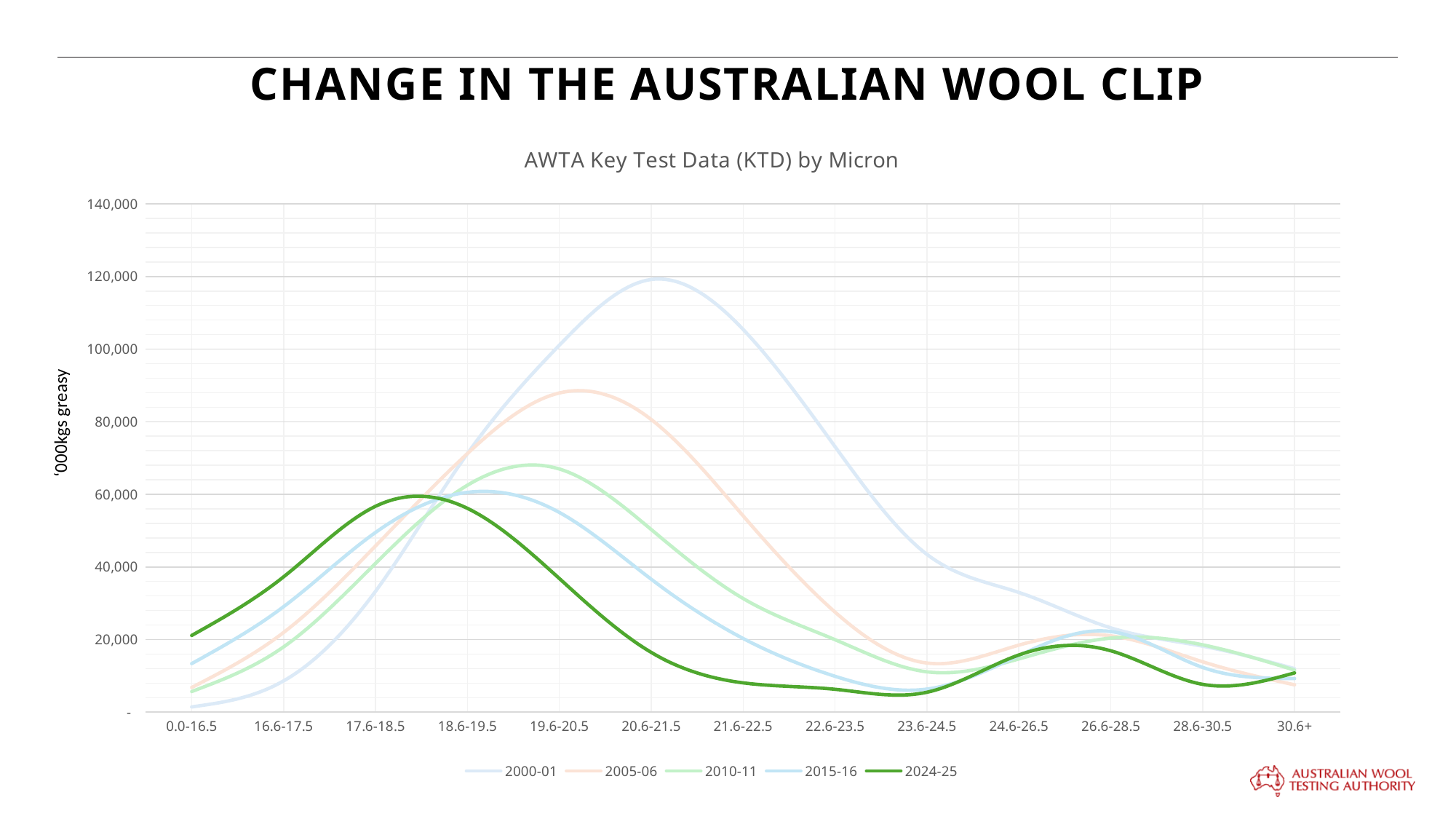
How many series does the legend list? 5 In which micron category does the 2000-01 series reach its highest value? 20.6-21.5 How many micron categories are shown on the x axis? 13 Does the 2024-25 series rise or fall from 18.6-19.5 to 23.6-24.5? fall What kind of chart is shown on the slide? line chart Which series reaches the highest value anywhere on the chart? 2000-01 At 20.6-21.5, which series has the larger value, 2000-01 or 2024-25? 2000-01 What is the label on the y axis? '000kgs greasy Is the value for 2000-01 at 20.6-21.5 greater or less than 100,000? greater Is the value for 2024-25 at 17.6-18.5 greater or less than 40,000? greater Is the value for 2005-06 at 19.6-20.5 greater or less than 80,000? greater